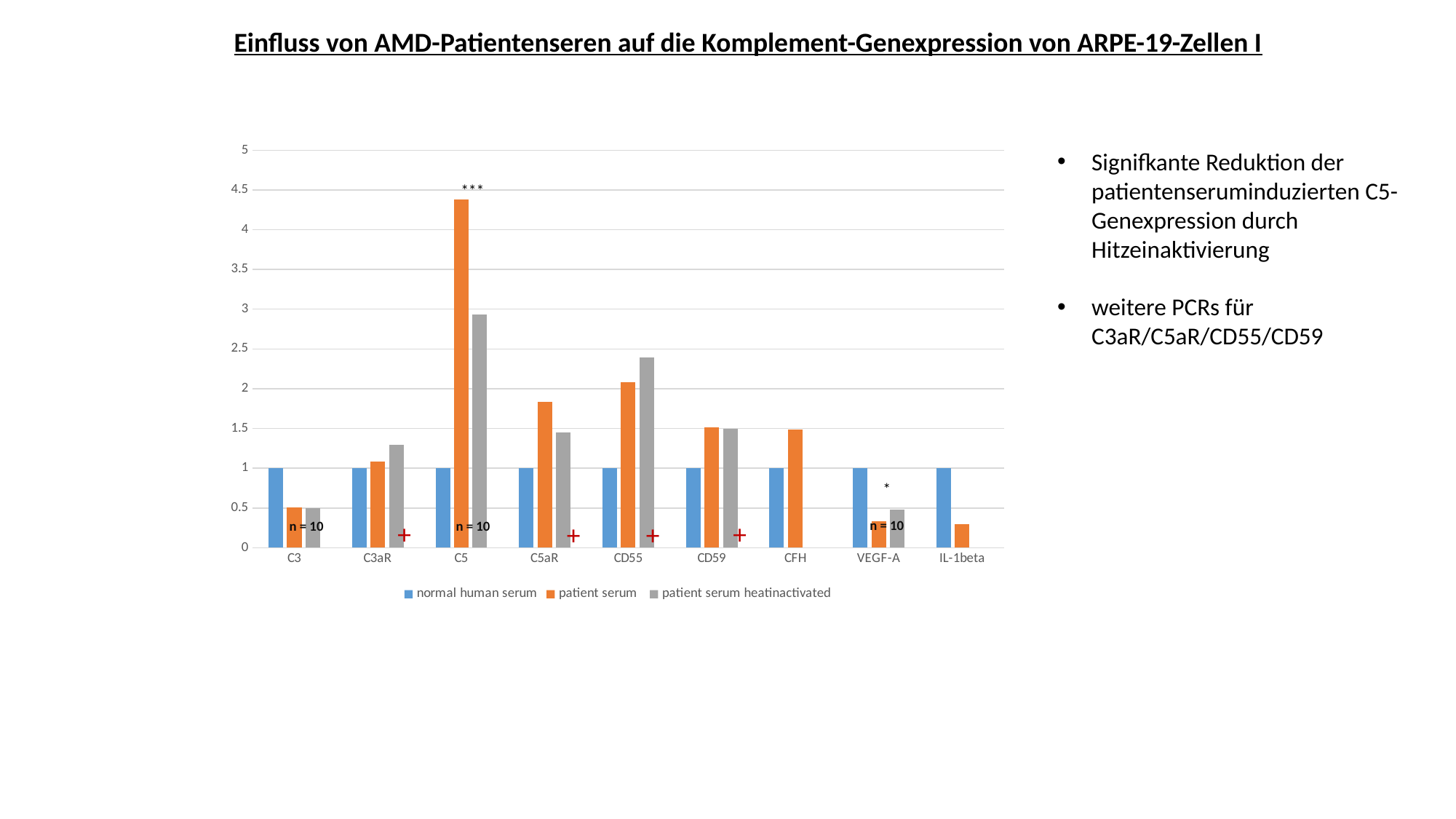
What kind of chart is shown on the slide? bar chart Is the patient serum value for C3 greater or less than 1? less What is the value for normal human serum at C3? 1 How many categories are shown on the x axis of the chart? 9 Is the patient serum value for CD59 greater or less than 1? greater Which series is shown in orange in the chart's legend? patient serum At C5aR, which is larger: patient serum or patient serum heatinactivated? patient serum How many series does the chart's legend list? 3 Is the patient serum value for C5 greater or less than 4? greater At CD55, which is larger: patient serum or patient serum heatinactivated? patient serum heatinactivated For which category is the patient serum value highest? C5